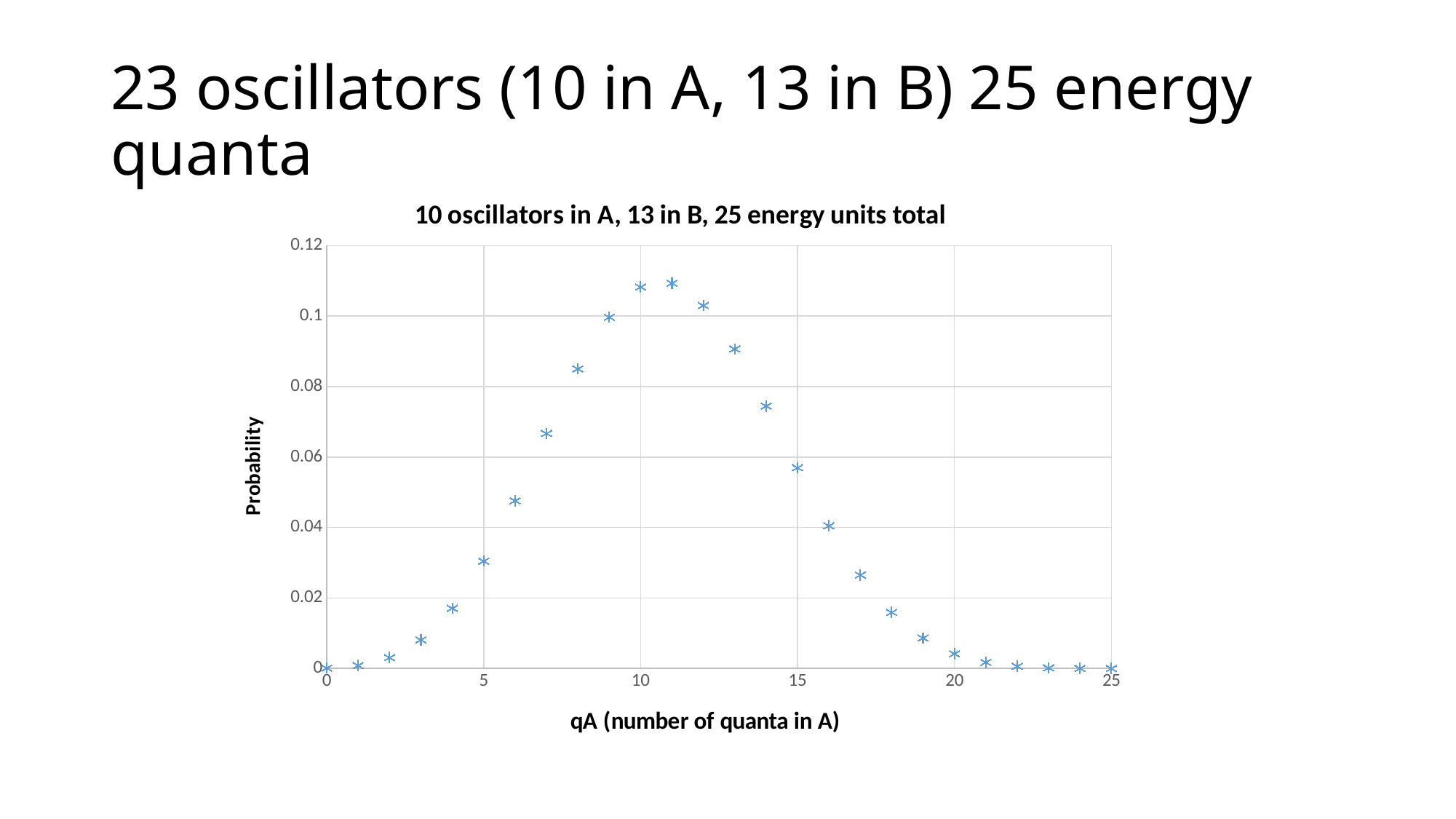
Is the probability at qA = 20 greater or less than 0.02? less Is the probability at qA = 3 greater or less than 0.02? less How many data points are plotted on the chart? 26 What is the title of the chart? 10 oscillators in A, 13 in B, 25 energy units total What is the label of the vertical axis? Probability Which has the higher probability, qA = 12 or qA = 13? qA = 12 Which has the higher probability, qA = 8 or qA = 14? qA = 8 Is the probability at qA = 13 greater or less than 0.08? greater Do the probabilities rise or fall as qA increases from 15 to 25? fall What kind of chart is shown on the slide? Scatter chart